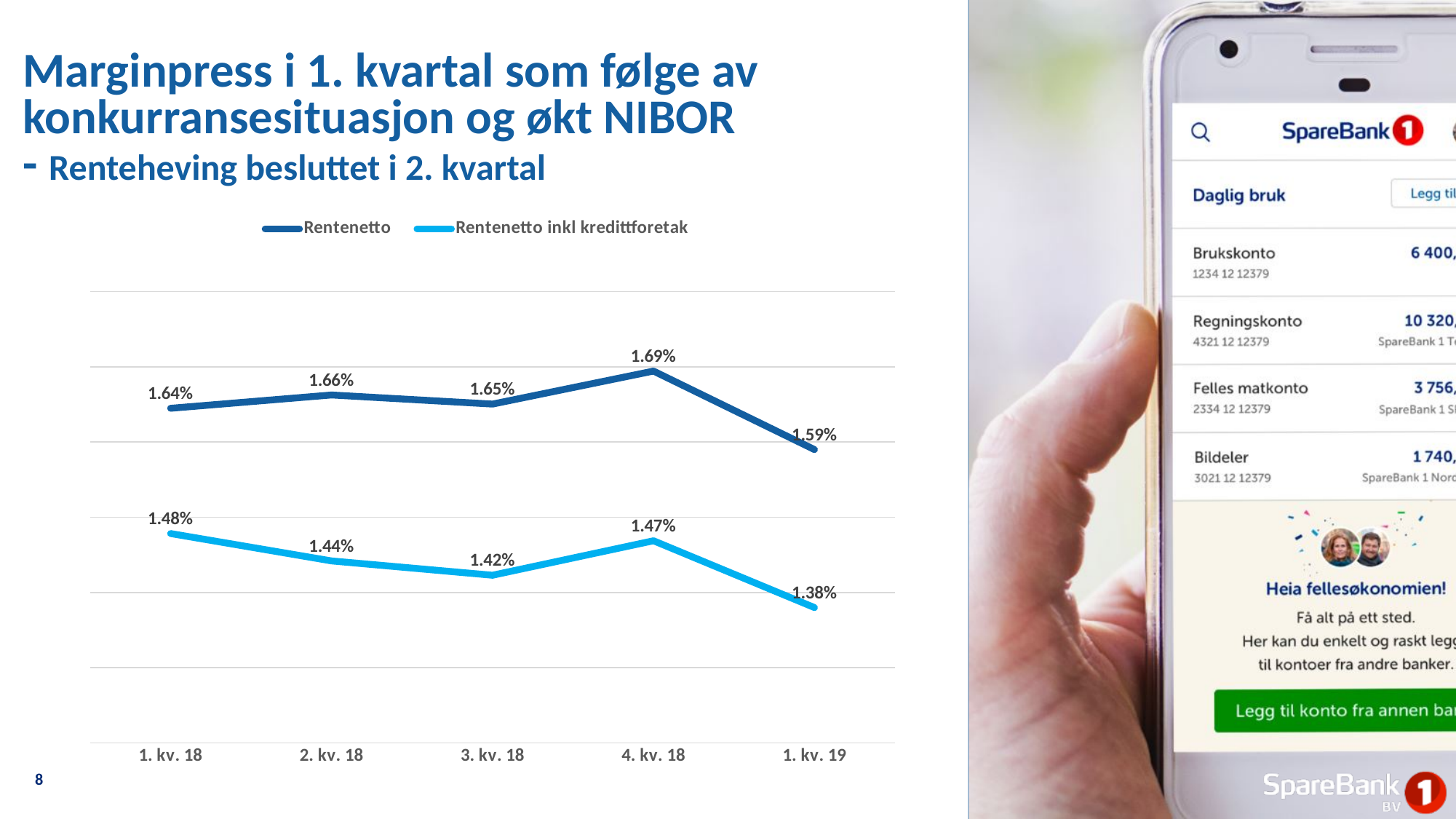
What is the difference between Rentenetto and Rentenetto inkl kredittforetak in 1. kv. 19? 0.21% What kind of chart is shown on the slide? Line chart How many quarters are shown on the x axis? 5 What is the value of Rentenetto in 4. kv. 18? 1.69% By how much did Rentenetto fall from 4. kv. 18 to 1. kv. 19? 0.10% What is the value of Rentenetto inkl kredittforetak in 3. kv. 18? 1.42% Does Rentenetto inkl kredittforetak rise or fall from 4. kv. 18 to 1. kv. 19? Fall In which quarter is Rentenetto highest? 4. kv. 18 How many series does the legend list? 2 What is the value of Rentenetto inkl kredittforetak in 1. kv. 19? 1.38% Which is larger: Rentenetto in 1. kv. 18 or Rentenetto in 2. kv. 18? 2. kv. 18 In which quarter is Rentenetto inkl kredittforetak lowest? 1. kv. 19